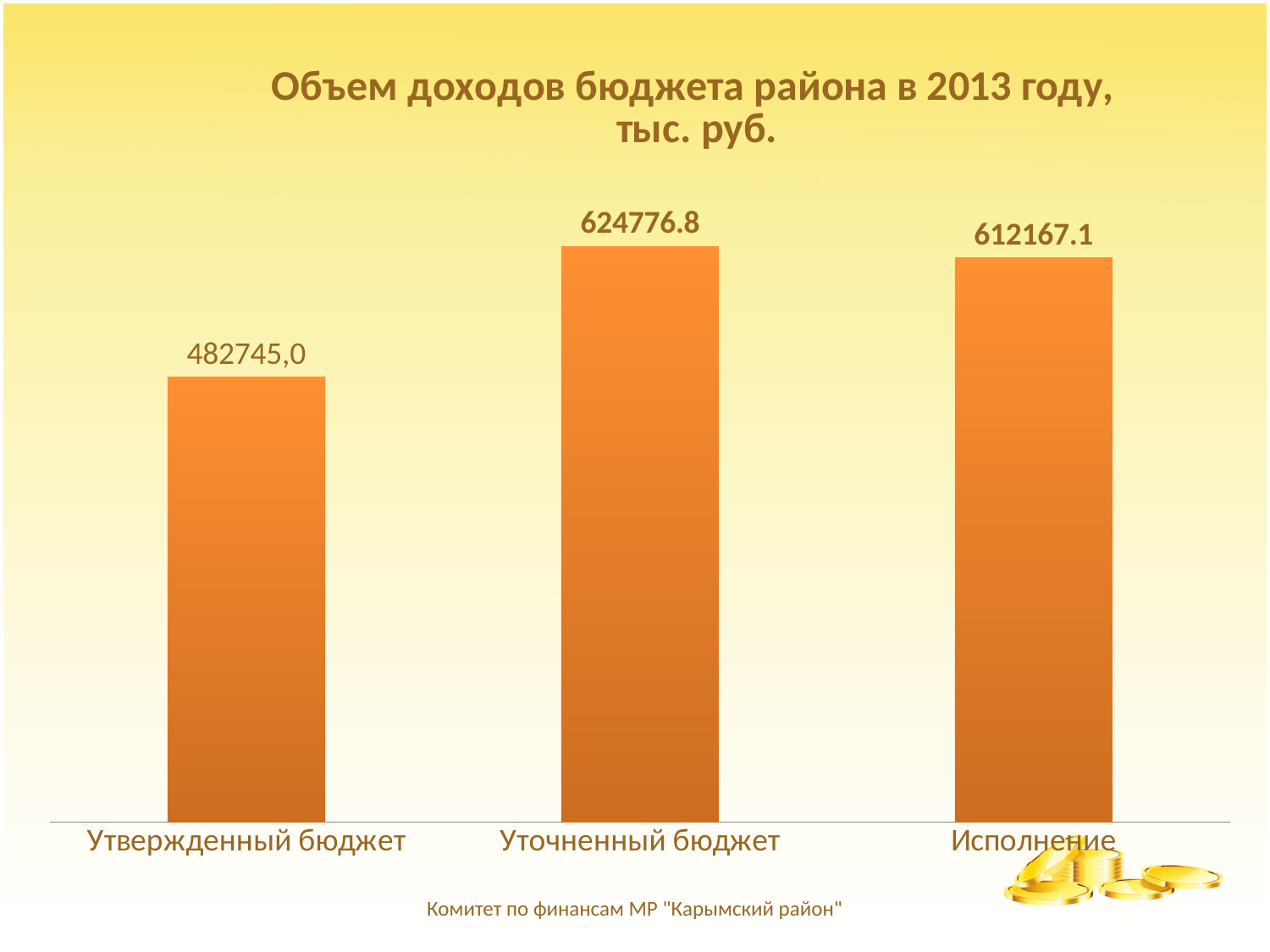
What kind of chart is shown on the slide? Bar chart What is the title of the chart? Объем доходов бюджета района в 2013 году, тыс. руб. Which is larger, Утвержденный бюджет or Исполнение? Исполнение How many categories are shown in the chart? 3 What is the value for Уточненный бюджет? 624776.8 Which is larger, Уточненный бюджет or Исполнение? Уточненный бюджет What is the value for Исполнение? 612167.1 Which category has the highest value? Уточненный бюджет What is the value for Утвержденный бюджет? 482745,0 Which category has the lowest value? Утвержденный бюджет What is the difference between Уточненный бюджет and Утвержденный бюджет? 142031.8 What is the difference between Уточненный бюджет and Исполнение? 12609.7